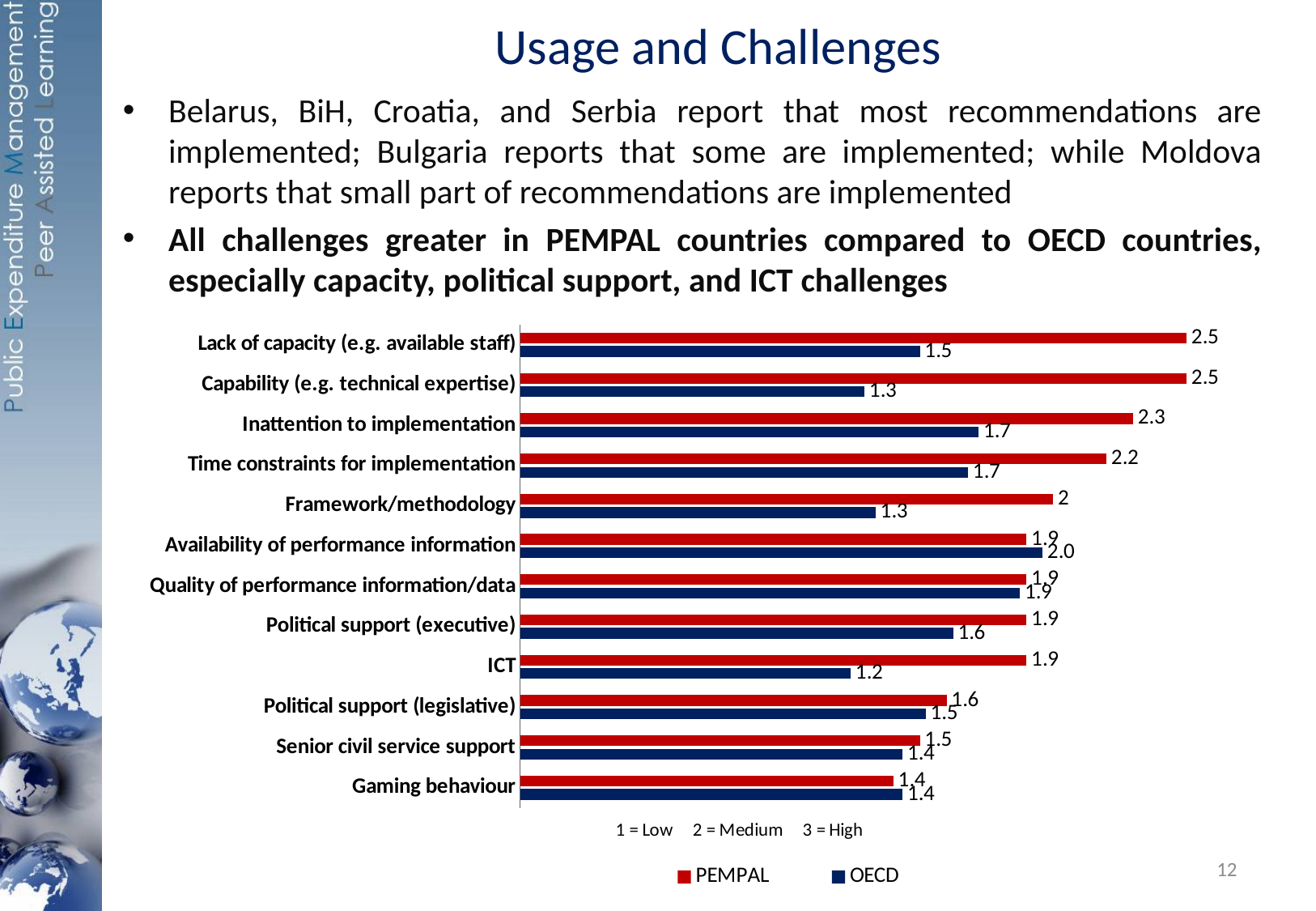
Which category has the lowest OECD value? ICT For ICT, which is larger, the PEMPAL value or the OECD value? PEMPAL What is the OECD value for Capability (e.g. technical expertise)? 1.3 Which category has the highest OECD value? Availability of performance information What is the PEMPAL value for Framework/methodology? 2 What type of chart is shown on the slide? Bar chart What is the PEMPAL value for ICT? 1.9 How many categories are shown in the chart? 12 What is the difference between the PEMPAL and OECD values for Lack of capacity (e.g. available staff)? 1.0 What is the OECD value for Availability of performance information? 2.0 How many series does the legend list? 2 Which category has the lowest PEMPAL value? Gaming behaviour